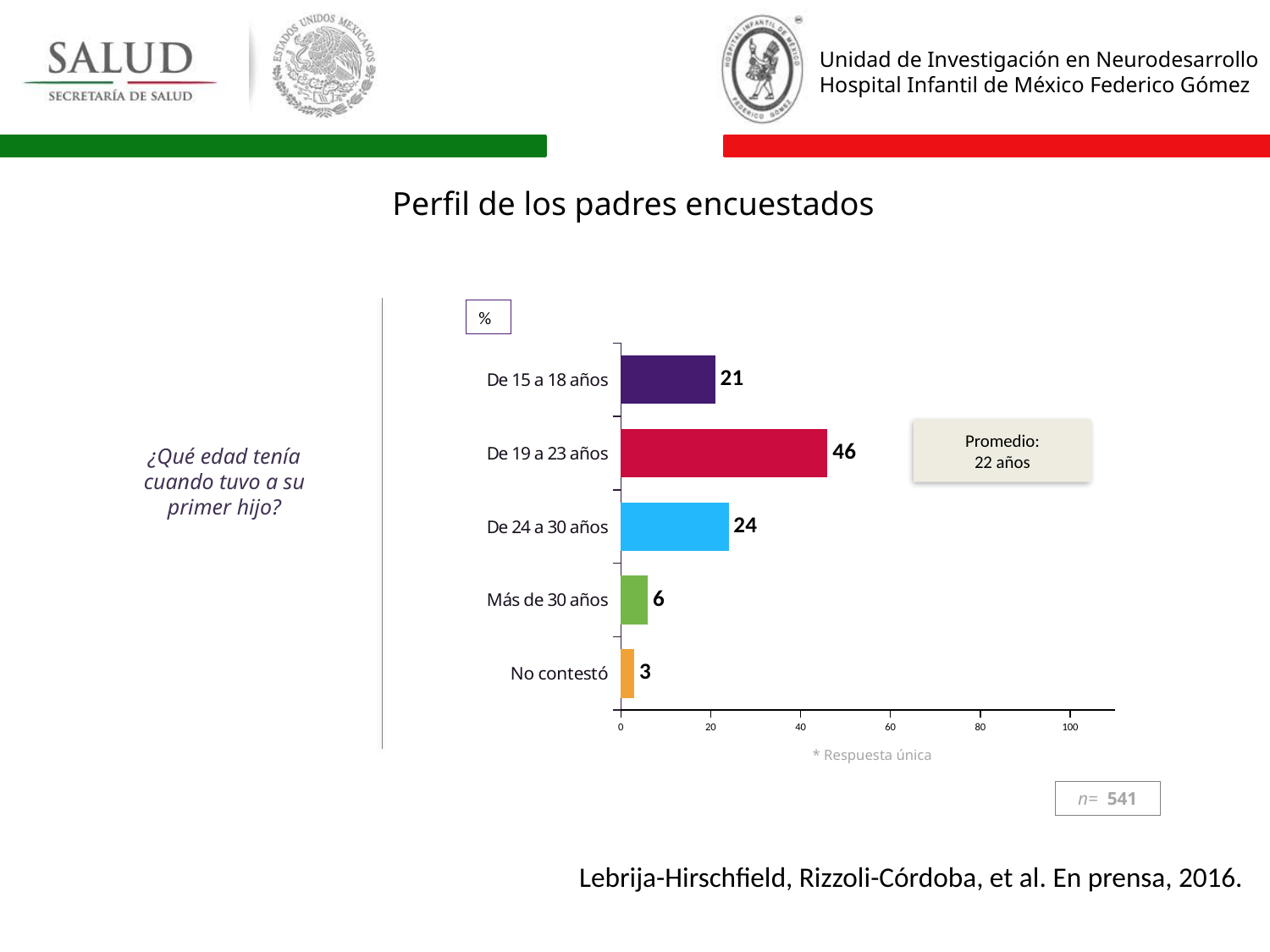
What is the difference between the values for 'De 19 a 23 años' and 'De 24 a 30 años'? 22 What is the value for 'De 19 a 23 años'? 46 What average (Promedio) is shown in the box next to the chart? 22 años What is the value for 'No contestó'? 3 What kind of chart is shown on the slide? bar chart What is the value for 'Más de 30 años'? 6 Which category has the lowest value? No contestó Is the value for 'De 19 a 23 años' greater or less than 40? greater What is the value for 'De 15 a 18 años'? 21 Which is larger, the value for 'De 24 a 30 años' or 'De 15 a 18 años'? De 24 a 30 años How many categories are shown in the chart? 5 Which category has the highest value? De 19 a 23 años